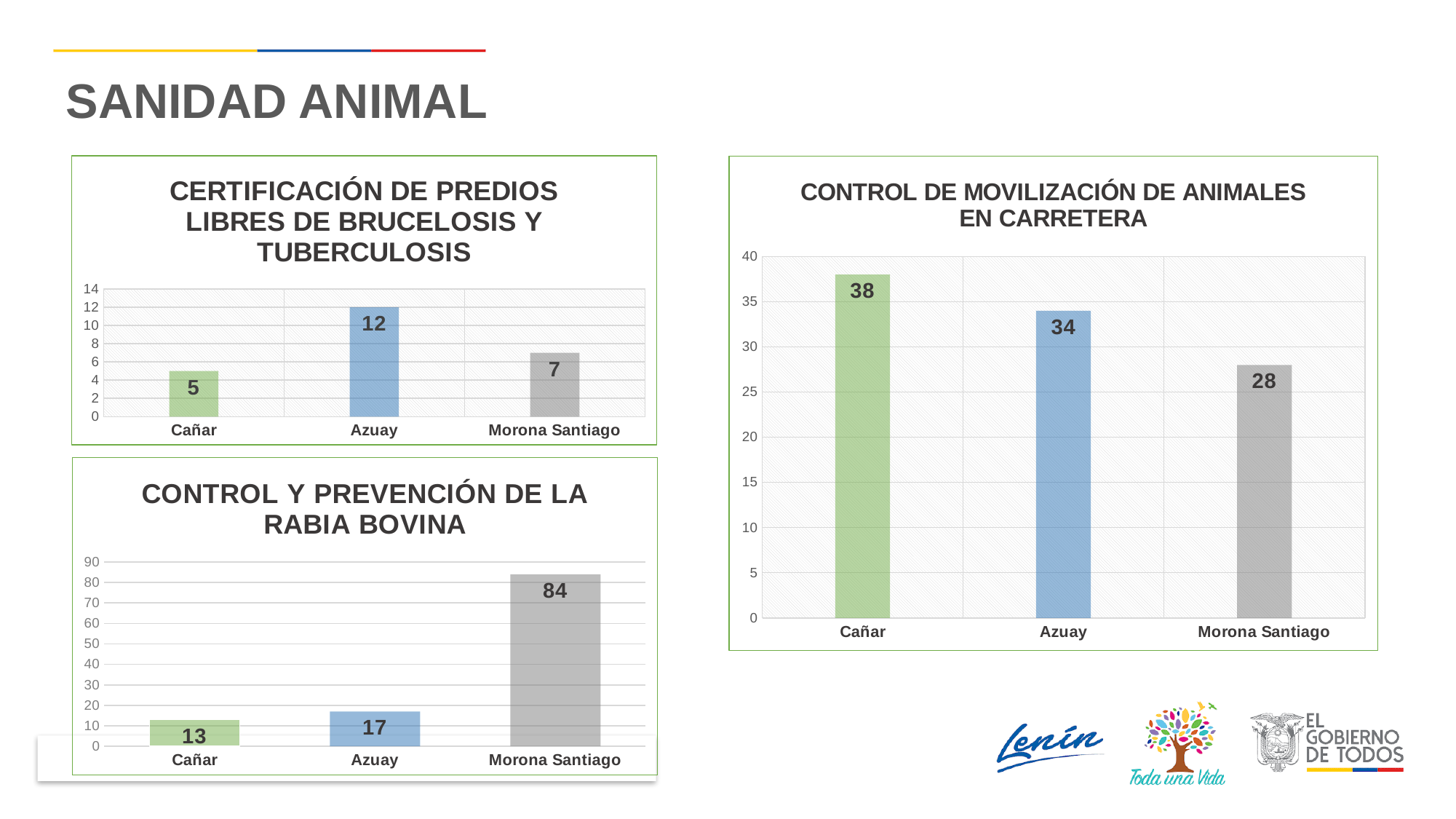
In the chart titled 'CONTROL Y PREVENCIÓN DE LA RABIA BOVINA', what is the difference between the values for Morona Santiago and Cañar? 71 In the chart titled 'CERTIFICACIÓN DE PREDIOS LIBRES DE BRUCELOSIS Y TUBERCULOSIS', what is the difference between the values for Azuay and Morona Santiago? 5 What kind of chart is the chart titled 'CONTROL Y PREVENCIÓN DE LA RABIA BOVINA'? bar chart In the chart titled 'CONTROL DE MOVILIZACIÓN DE ANIMALES EN CARRETERA', which category has the lowest value? Morona Santiago In the chart titled 'CONTROL Y PREVENCIÓN DE LA RABIA BOVINA', which is larger, the value for Cañar or the value for Azuay? Azuay In the chart titled 'CONTROL Y PREVENCIÓN DE LA RABIA BOVINA', which category has the highest value? Morona Santiago How many categories are shown in the chart titled 'CONTROL DE MOVILIZACIÓN DE ANIMALES EN CARRETERA'? 3 In the chart titled 'CONTROL DE MOVILIZACIÓN DE ANIMALES EN CARRETERA', do the values rise or fall from Cañar to Morona Santiago along the x axis? fall In the chart titled 'CERTIFICACIÓN DE PREDIOS LIBRES DE BRUCELOSIS Y TUBERCULOSIS', which category has the lowest value? Cañar In the chart titled 'CERTIFICACIÓN DE PREDIOS LIBRES DE BRUCELOSIS Y TUBERCULOSIS', what is the value for Azuay? 12 In the chart titled 'CONTROL Y PREVENCIÓN DE LA RABIA BOVINA', what is the value for Morona Santiago? 84 In the chart titled 'CONTROL DE MOVILIZACIÓN DE ANIMALES EN CARRETERA', what is the value for Cañar? 38